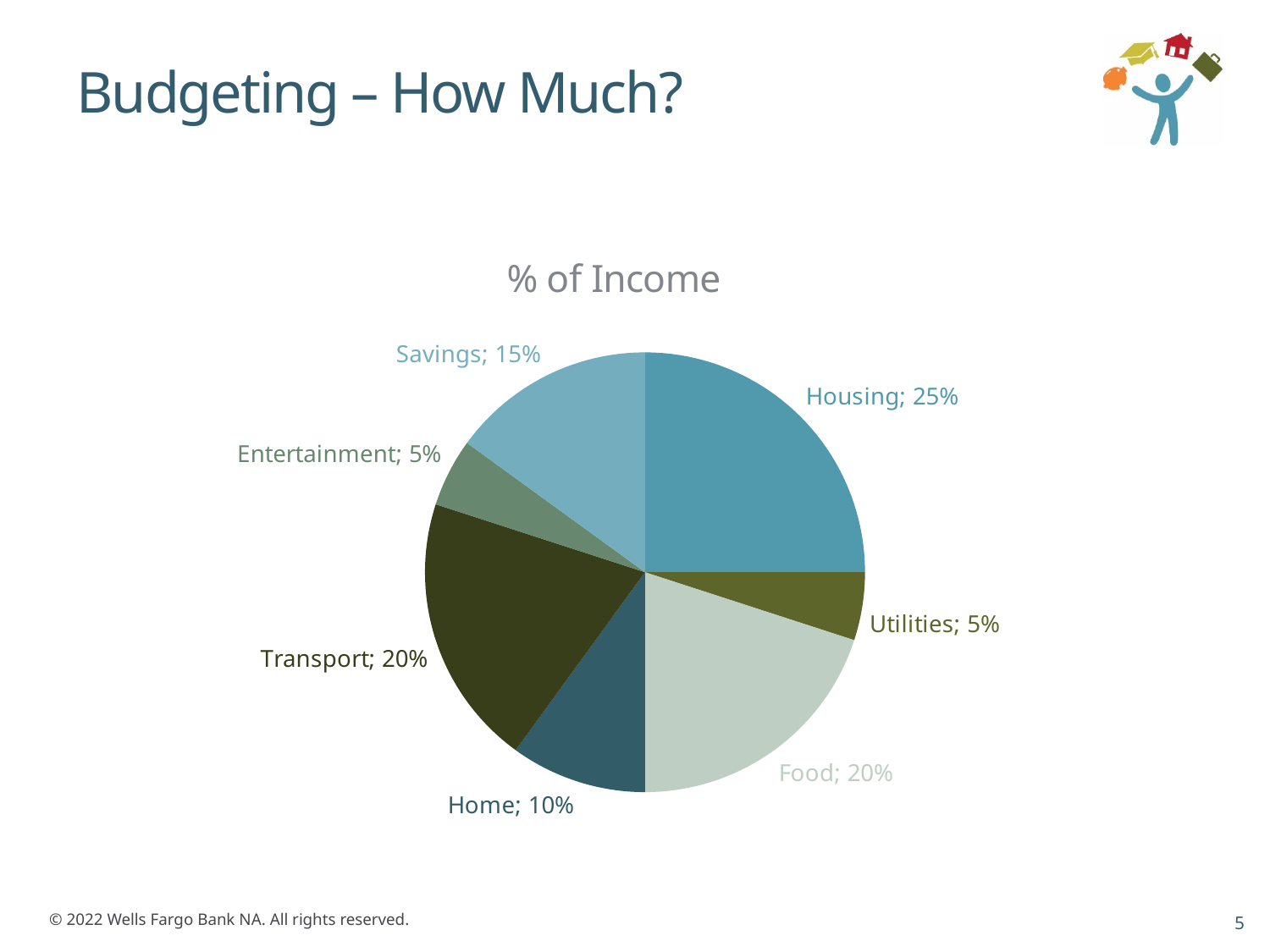
Is the Food slice greater or less than 15%? greater What kind of chart is shown on the slide? Pie chart Which two categories each account for 5% of income? Entertainment and Utilities How many categories are shown in the pie chart? 7 What is the difference between the Housing and Savings percentages? 10% What is the title of the chart? % of Income What share of income goes to Home? 10% What is the combined percentage for Food and Transport? 40% What percentage of income does the chart show for Housing? 25% Which is larger, the Transport slice or the Home slice? Transport Which category has the largest slice of the pie? Housing What percentage of income is allocated to Savings? 15%